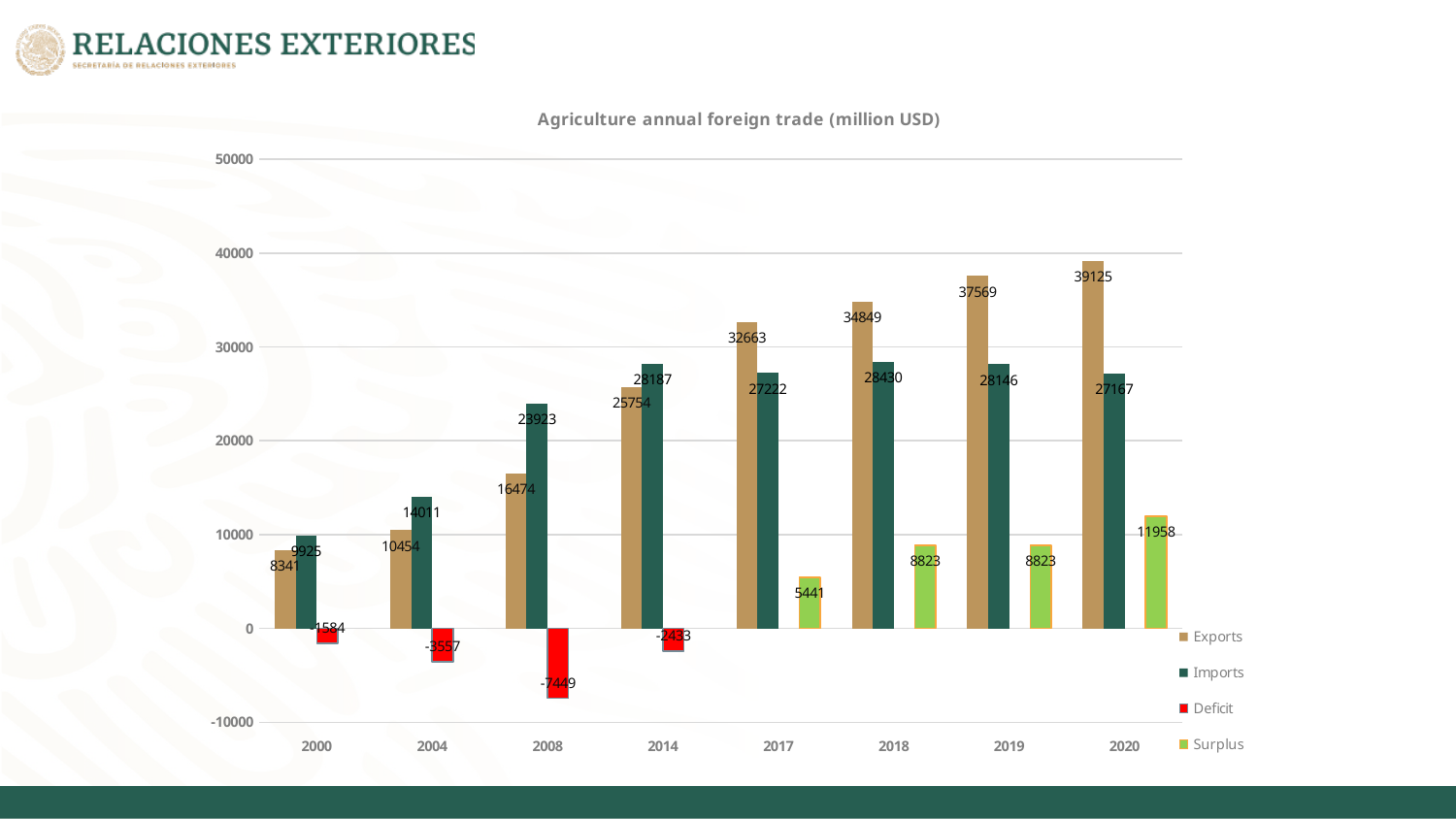
How many years are shown on the x axis? 8 Is the value for Exports in 2018 greater or less than 30000? greater What is the Surplus value shown for 2017? 5441 What kind of chart is shown on the slide? Bar chart What is the value of Exports in 2020? 39125 Which is larger in 2014, Exports or Imports? Imports What is the difference between Exports and Imports in 2019? 9423 In which year are Exports lowest? 2000 In which year are Exports highest? 2020 How many series does the legend list? 4 What is the Deficit value shown for 2008? -7449 What is the value of Imports in 2008? 23923